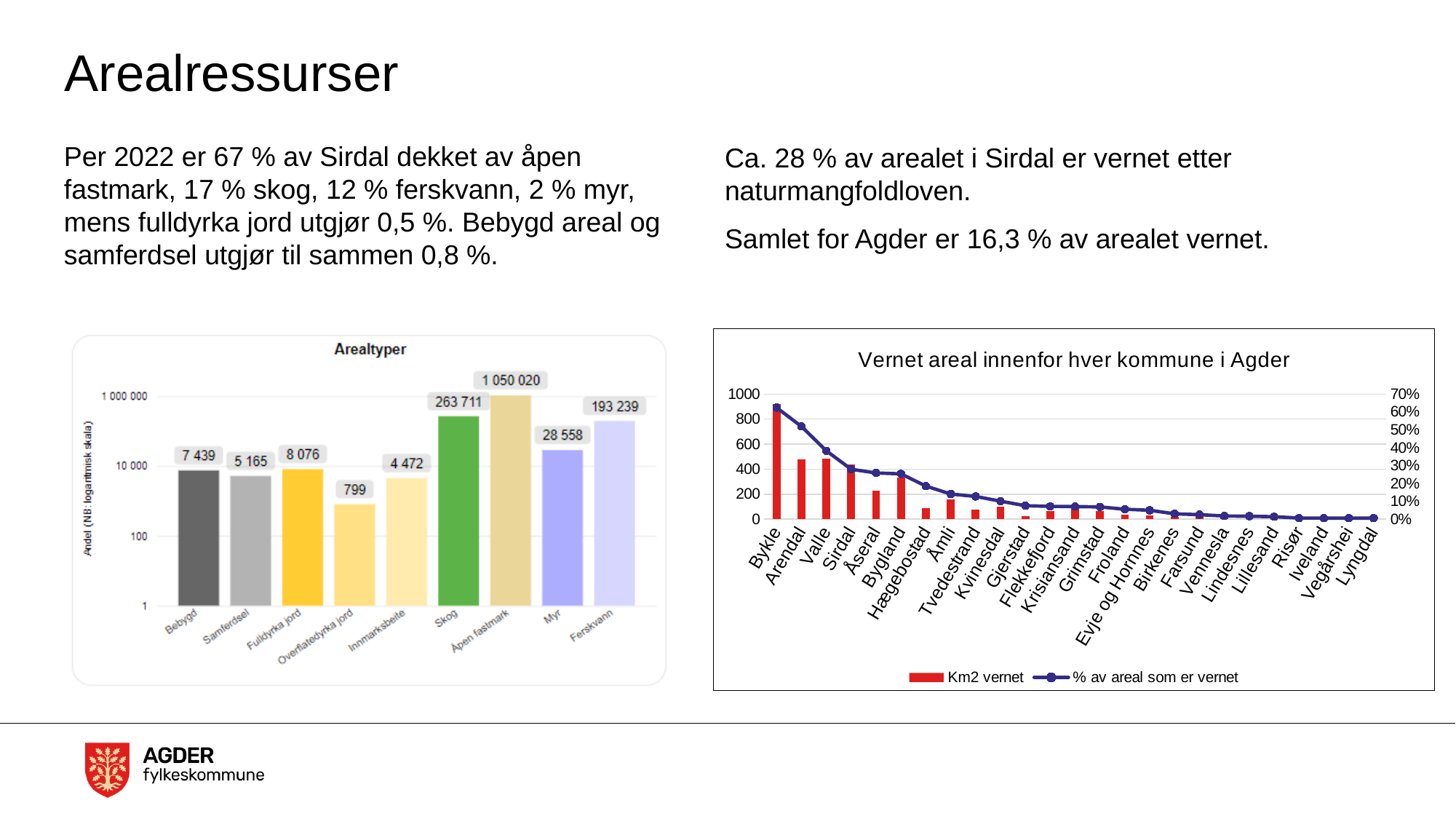
In the Arealtyper chart, what is the difference between Bebygd and Samferdsel? 2 274 In the chart 'Vernet areal innenfor hver kommune i Agder', is the Km2 vernet value for Bykle greater or less than 800? greater How many categories are shown in the Arealtyper chart? 9 In the chart 'Vernet areal innenfor hver kommune i Agder', does the '% av areal som er vernet' line rise or fall from left to right? Fall In the chart 'Vernet areal innenfor hver kommune i Agder', which municipality has the highest Km2 vernet? Bykle In the Arealtyper chart, which category has the lowest value? Overflatedyrka jord What kind of chart is the Arealtyper chart? Bar chart In the Arealtyper chart, which is larger, Myr or Ferskvann? Ferskvann How many series does the legend of the chart 'Vernet areal innenfor hver kommune i Agder' list? 2 In the Arealtyper chart, what is the value for Overflatedyrka jord? 799 In the Arealtyper chart, what is the value for Skog? 263 711 In the Arealtyper chart, which category has the highest value? Åpen fastmark